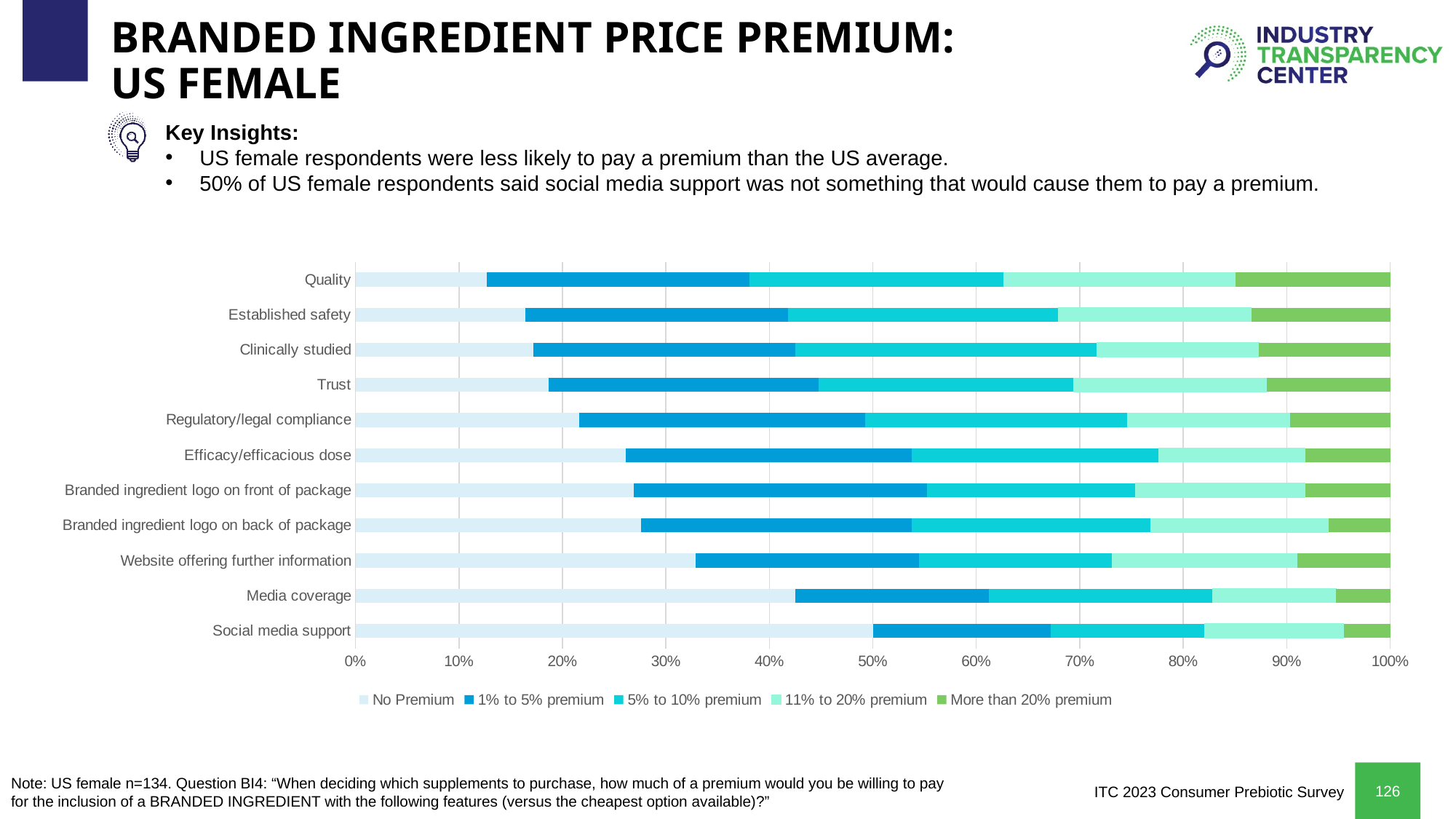
Which has a larger 'No Premium' segment: Media coverage or Trust? Media coverage How many series does the chart legend list? 5 How many categories (features) are listed on the chart's vertical axis? 11 What kind of chart is shown on the slide? Stacked bar chart What is the first series listed in the chart legend? No Premium Moving down the categories from Quality to Social media support, does the 'No Premium' segment generally increase or decrease? increase Is the 'No Premium' value for Website offering further information greater or less than 30%? greater Which category has the smallest 'No Premium' segment? Quality Which category has the largest 'More than 20% premium' segment? Quality Which category has the largest 'No Premium' segment? Social media support Is the 'No Premium' value for Media coverage greater or less than 40%? greater Is the 'No Premium' value for Quality greater or less than 20%? less